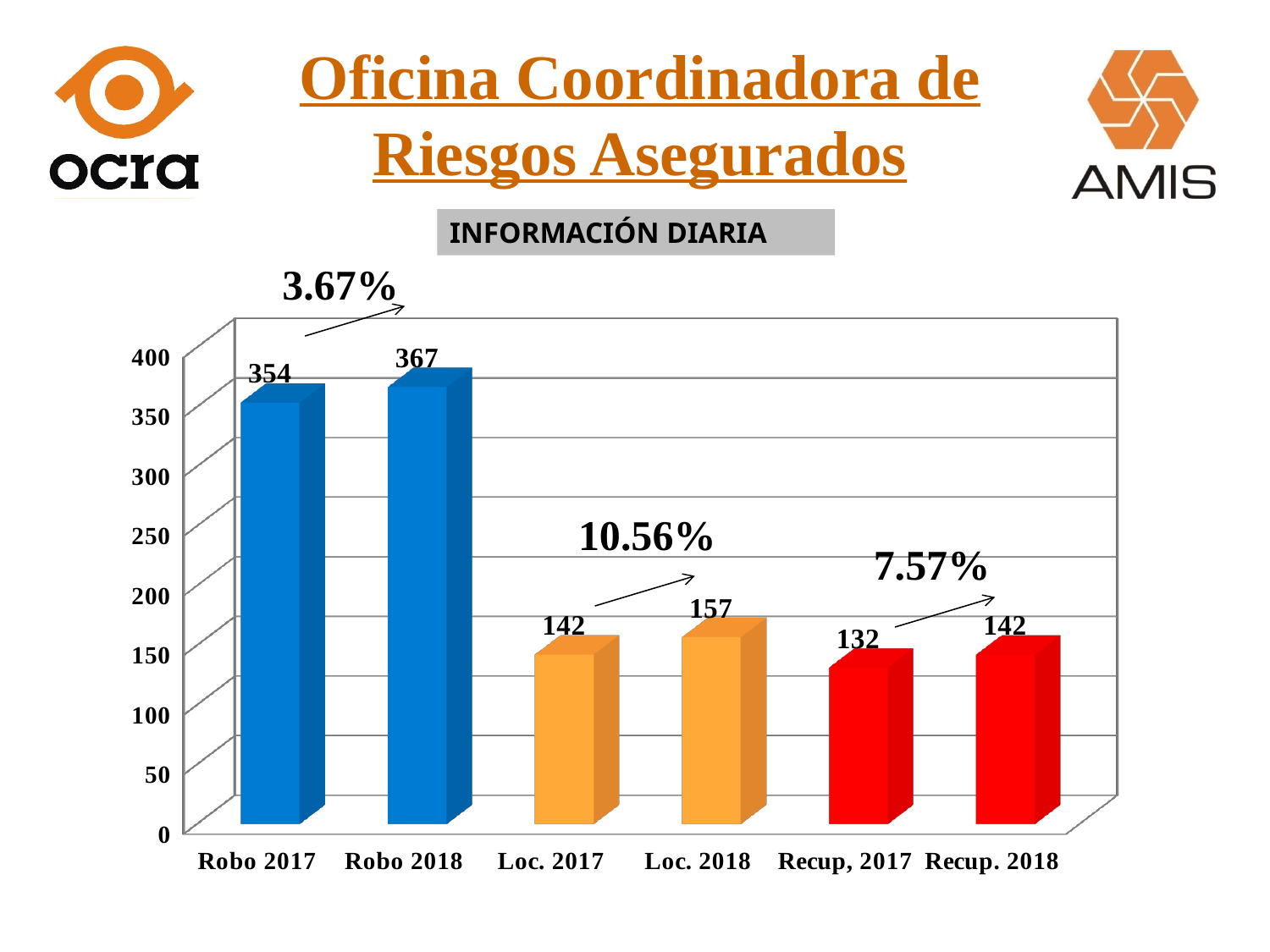
What is the value for Loc. 2018? 157 Which category has the lowest value? Recup, 2017 What is the difference between Loc. 2018 and Loc. 2017? 15 What is the value for Robo 2018? 367 What percentage change is shown above the Loc. bars? 10.56% Which is larger, Loc. 2017 or Recup. 2018? They are equal (142) What is the value for Recup, 2017? 132 What is the value for Robo 2017? 354 Which category has the highest value? Robo 2018 How many bars are shown in the chart? 6 What is the difference between Robo 2018 and Robo 2017? 13 What kind of chart is shown on the slide? Bar chart